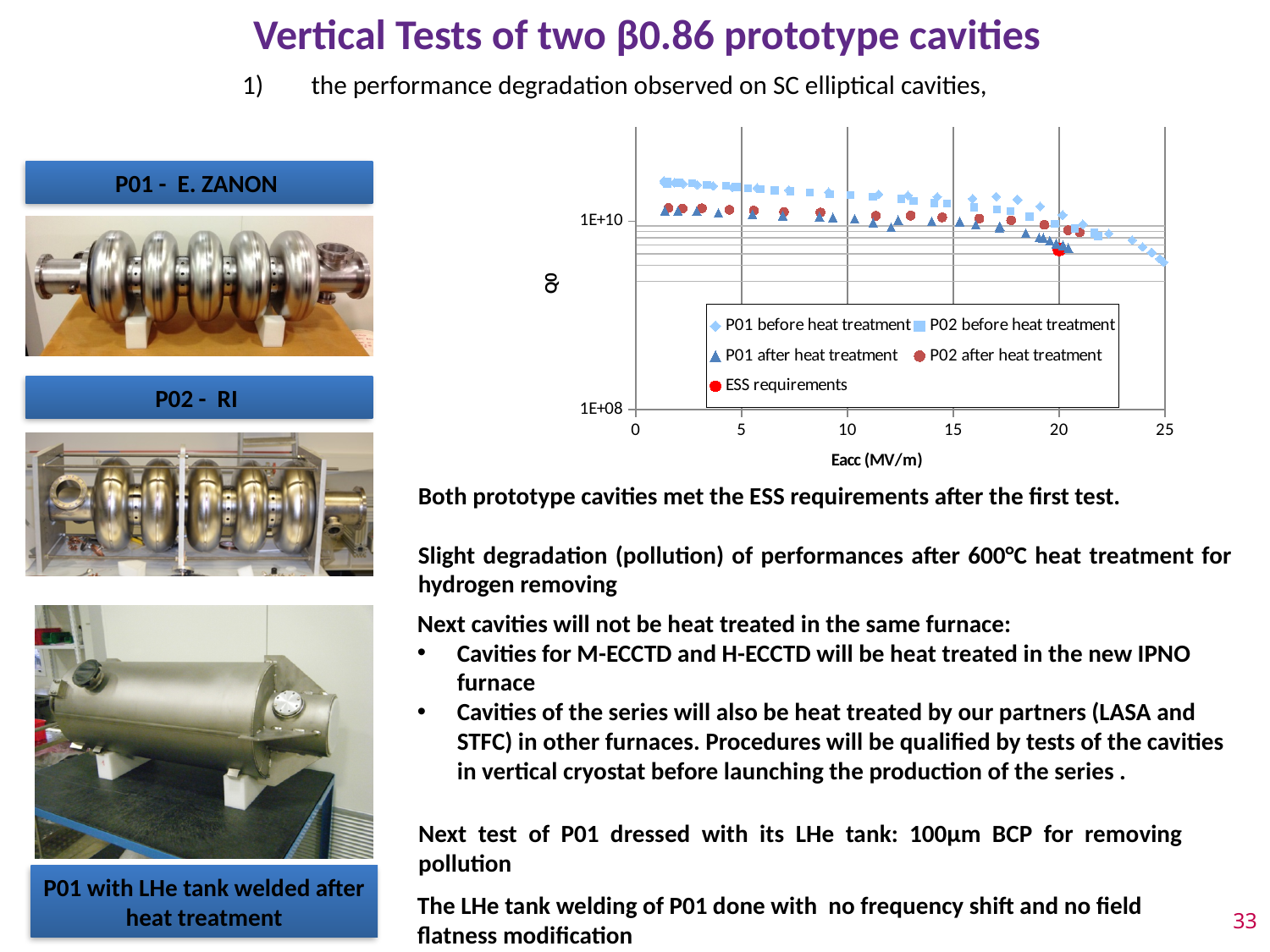
What is the label of the x axis of the chart? Eacc (MV/m) Is the Q0 value of the ESS requirements point greater or less than 1E+10? less What is the label of the y axis of the chart? Q0 What kind of chart is shown on the slide? scatter chart Does Q0 rise or fall as Eacc increases for the P01 before heat treatment series? fall How many series does the chart legend list? 5 What is the highest Eacc value shown on the x axis of the chart? 25 Is the Q0 value of the P01 before heat treatment series at Eacc 25 MV/m greater or less than 1E+10? less Is the Q0 value of the ESS requirements point greater or less than 1E+08? greater At Eacc around 10 MV/m, which series has the higher Q0: P02 before heat treatment or P02 after heat treatment? P02 before heat treatment At Eacc around 5 MV/m, which series has the higher Q0: P01 before heat treatment or P01 after heat treatment? P01 before heat treatment